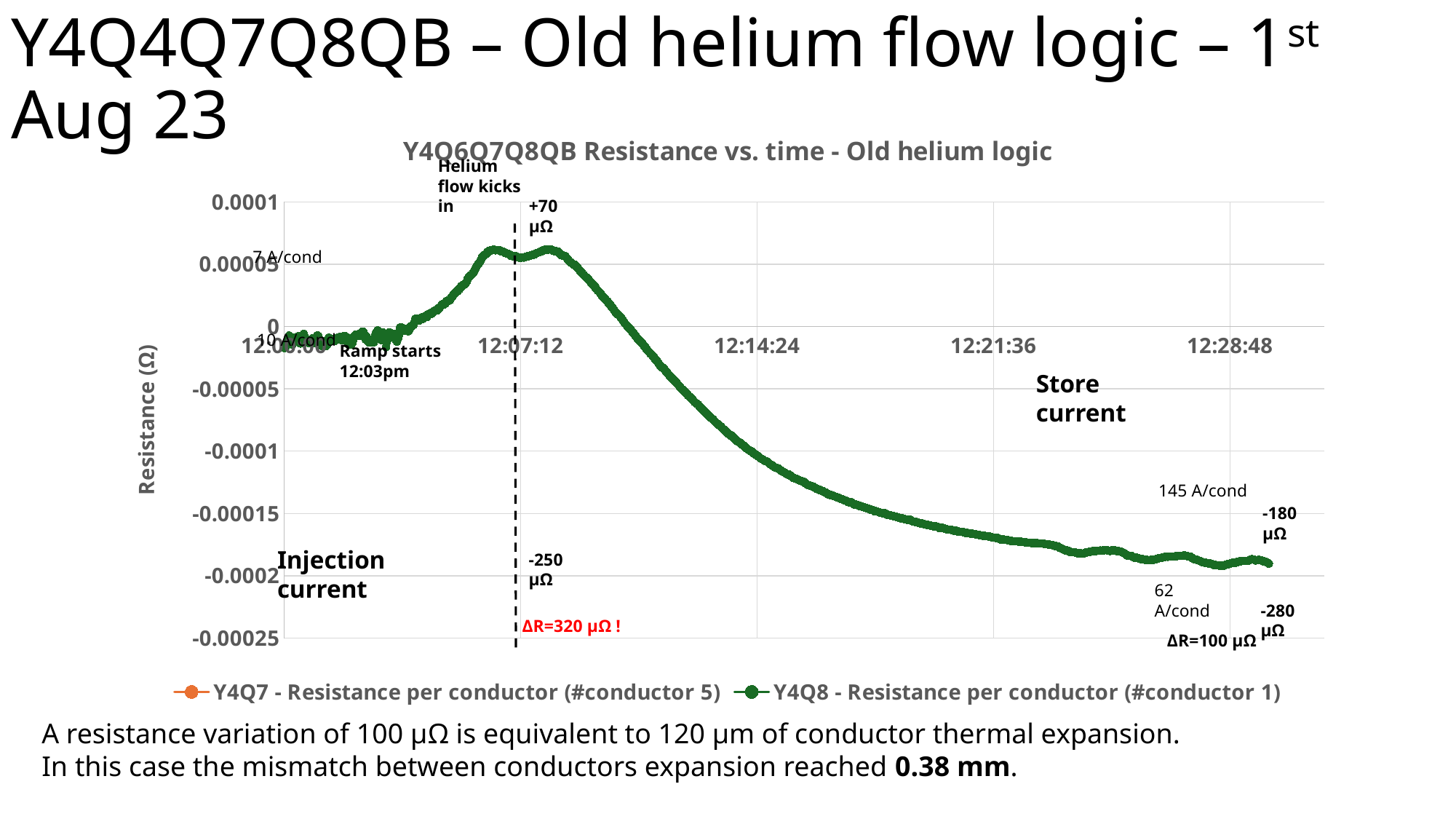
Is the Y4Q8 resistance at 12:21:36 greater or less than -0.00015? less What is the lowest value shown on the vertical axis? -0.00025 What kind of chart is shown on the slide? line chart After 12:07:12, does the Y4Q8 resistance rise or fall over time? fall What is the title of the chart? Y4Q6Q7Q8QB Resistance vs. time - Old helium logic Is the Y4Q8 resistance at 12:07:12 greater or less than 0? greater What is the highest value shown on the vertical axis? 0.0001 What ΔR value is annotated at the dashed line where the helium flow kicks in? ΔR=320 µΩ At what time does the annotation say the ramp starts? 12:03pm What ΔR value is annotated at the right end of the chart, near the store current? ΔR=100 µΩ What is the label of the vertical axis? Resistance (Ω) How many series does the chart legend list? 2